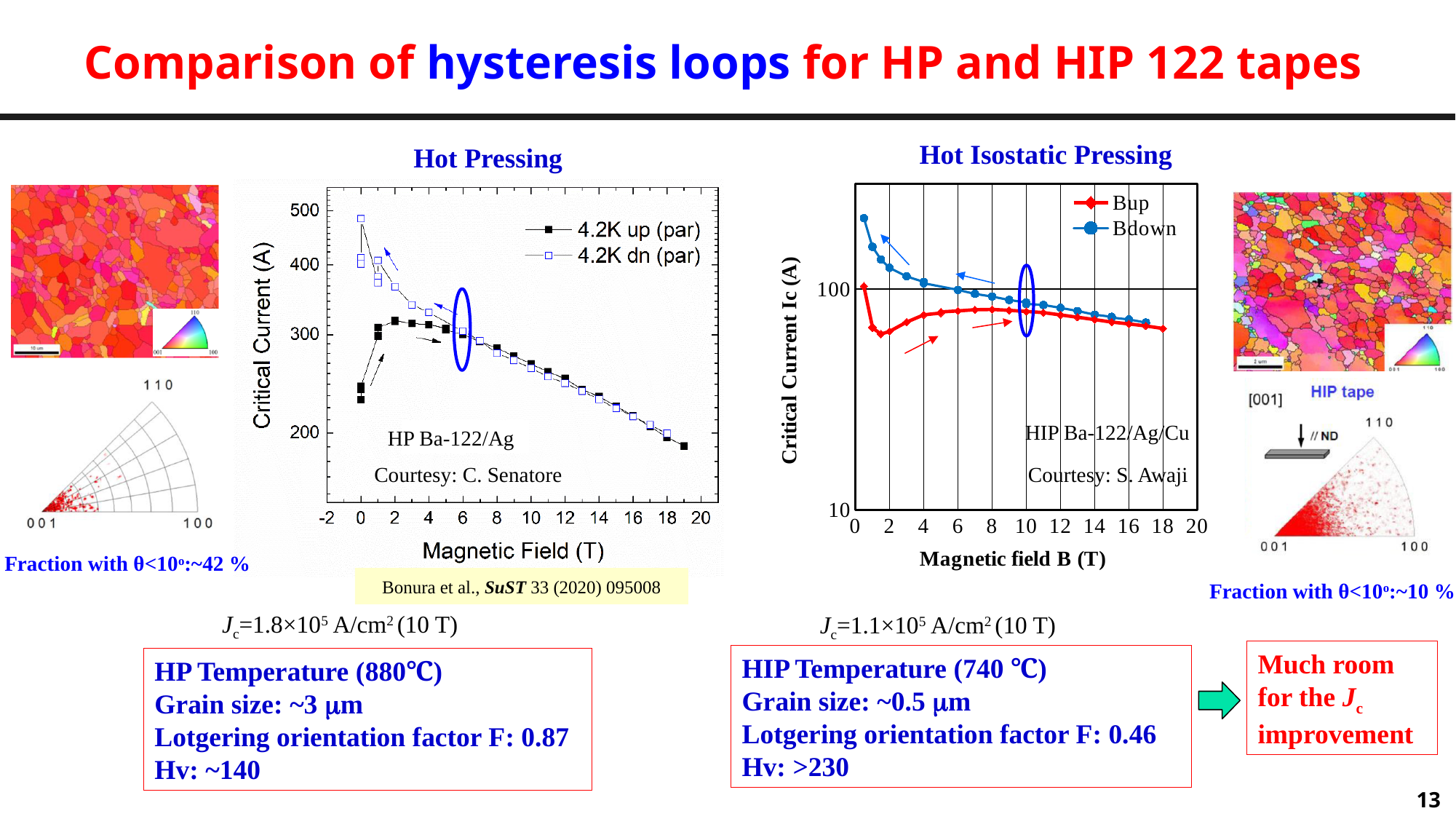
How many series does the legend of the Hot Pressing chart list? 2 What kind of chart is the Hot Pressing chart on the left? line chart In the Hot Pressing chart, does the critical current rise or fall as the magnetic field increases from 6 T to 18 T? fall In the Hot Isostatic Pressing chart, which series has the higher critical current at 2 T, Bup or Bdown? Bdown In the Hot Pressing chart, which series has the higher critical current at 2 T, 4.2K up (par) or 4.2K dn (par)? 4.2K dn (par) What are the two legend entries of the Hot Pressing chart? 4.2K up (par) and 4.2K dn (par) In the Hot Isostatic Pressing chart, is the Bdown value at the lowest field (near 0 T) greater or less than 100? greater In the Hot Pressing chart, is the critical current at 14 T greater or less than 300? less How many series does the legend of the Hot Isostatic Pressing chart list? 2 In the Hot Pressing chart, what is the label of the y axis? Critical Current (A) In the Hot Pressing chart, is the 4.2K up (par) value at 0 T greater or less than 300? less